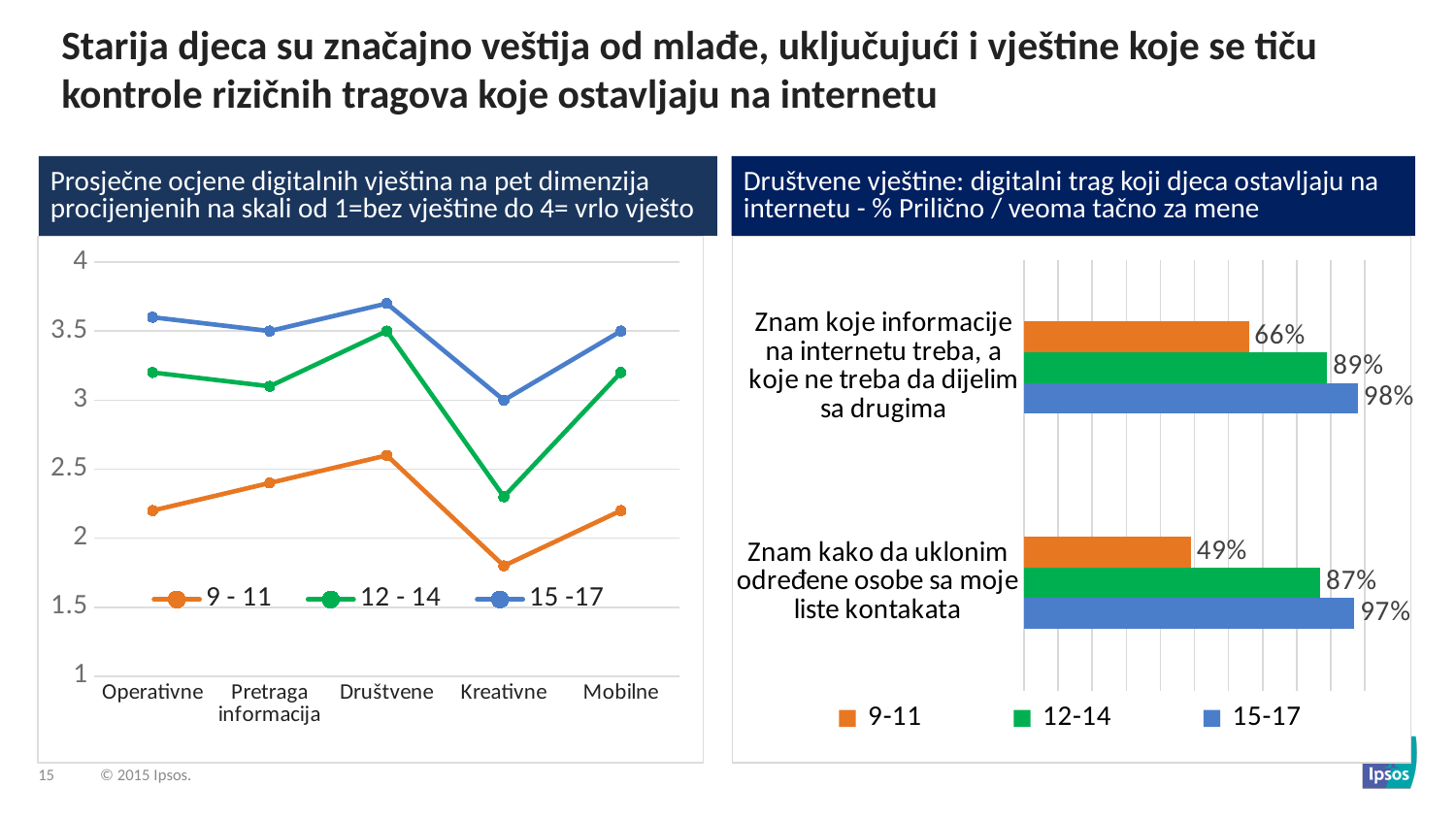
What kind of chart is the right chart (Društvene vještine: digitalni trag)? bar chart In the right chart, what is the value for the 15-17 group for 'Znam koje informacije na internetu treba, a koje ne treba da dijelim sa drugima'? 98% How many series does the legend of the left chart list? 3 In the left chart, which series has the highest value for Društvene? 15 -17 In the right chart, what is the value for the 9-11 group for 'Znam kako da uklonim određene osobe sa moje liste kontakata'? 49% What kind of chart is the left chart (Prosječne ocjene digitalnih vještina)? line chart In the left chart, is the value for Kreativne in the 9 - 11 series greater or less than 2? less In the left chart, is the value for Kreativne in the 12 - 14 series greater or less than 2.5? less In the right chart, what is the difference between the 12-14 and 9-11 values for 'Znam koje informacije na internetu treba, a koje ne treba da dijelim sa drugima'? 23% How many categories are shown on the x axis of the left chart? 5 In the left chart, which category has the lowest value for the 9 - 11 series? Kreativne In the right chart, which group has the lowest value for 'Znam kako da uklonim određene osobe sa moje liste kontakata'? 9-11